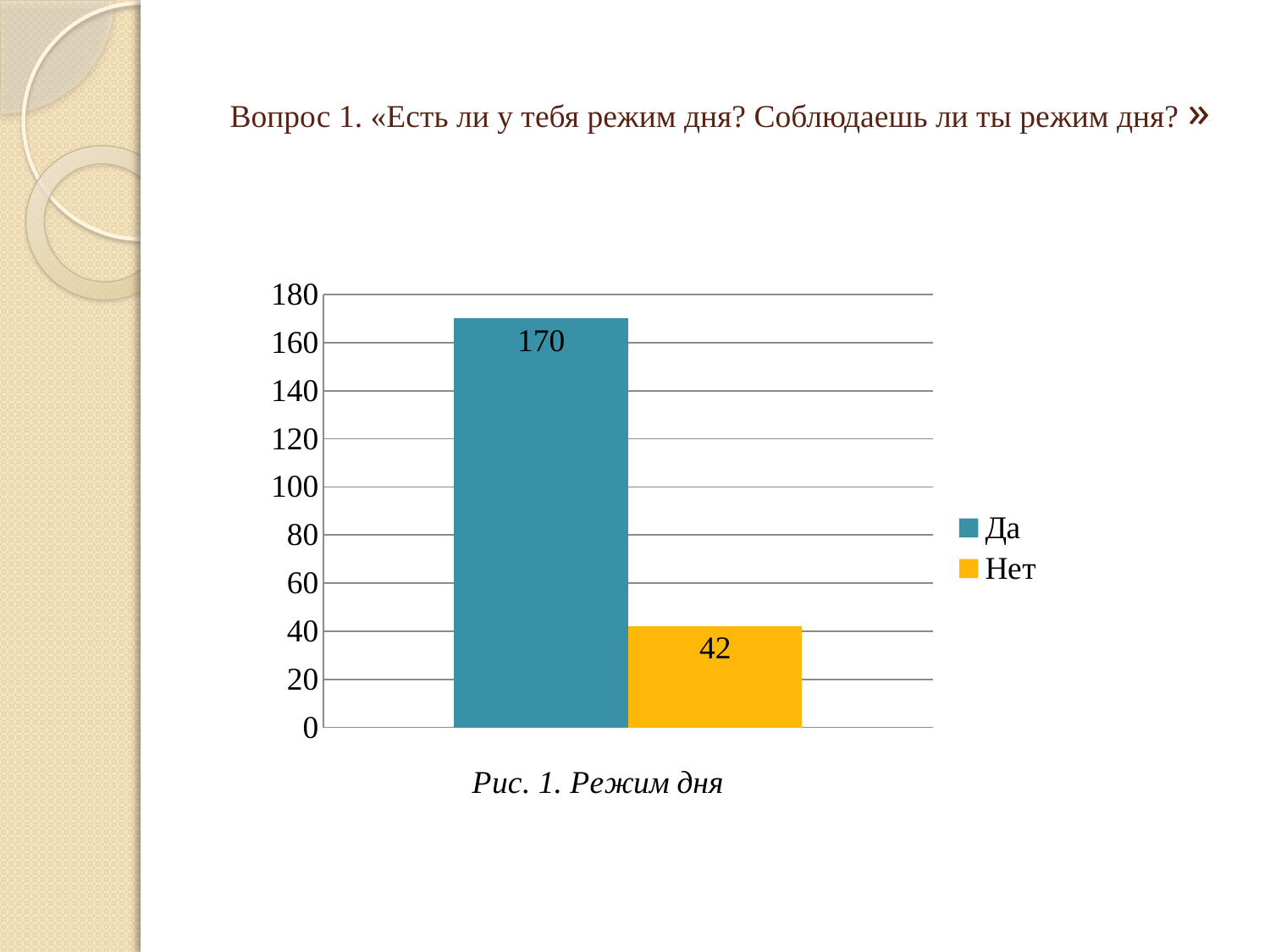
What is the value for "Да"? 170 What is the caption below the chart? Рис. 1. Режим дня Which is larger, the value for "Да" or the value for "Нет"? Да What is the difference between the values for "Да" and "Нет"? 128 Which series has the highest value? Да How many series does the legend list? 2 What is the value for "Нет"? 42 Is the value for "Нет" greater or less than 60? less Is the value for "Да" greater or less than 160? greater Which series has the lowest value? Нет What kind of chart is shown on the slide? bar chart What is the total of the two values shown in the chart? 212